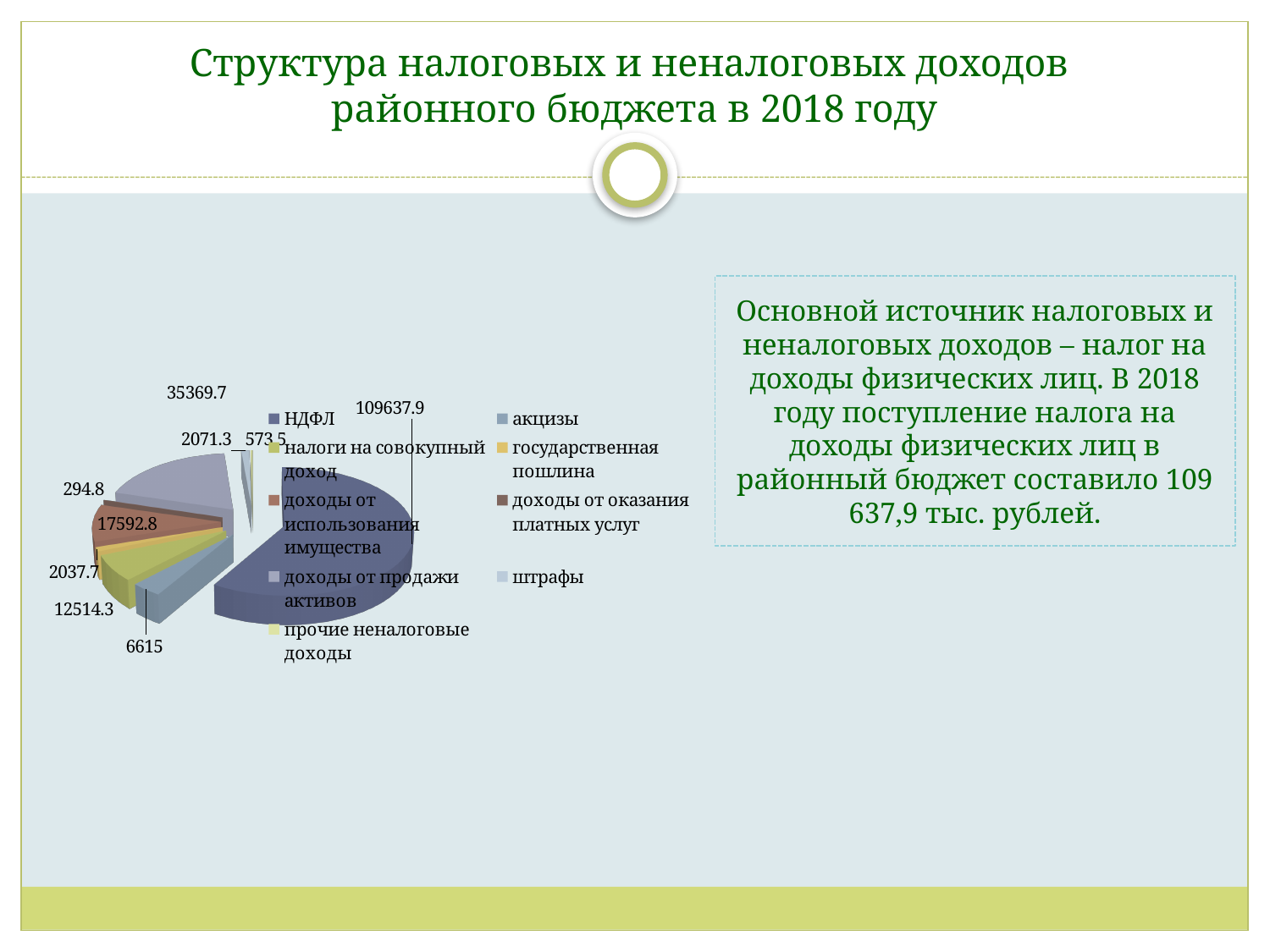
How many entries does the legend of the pie chart list? 9 Which legend entry is listed first in the pie chart's legend? НДФЛ What kind of chart is shown on the slide? pie chart What is the largest data label shown on the pie chart? 109637.9 Is the value for НДФЛ greater or less than 100000? greater How many slices (data labels) does the pie chart have? 9 Which category has the largest slice of the pie chart? НДФЛ What is the title of the slide containing the pie chart? Структура налоговых и неналоговых доходов районного бюджета в 2018 году What is the difference between the largest data label (109637.9) and the second largest (35369.7) on the pie chart? 74268.2 What value is shown for НДФЛ on the pie chart? 109637.9 What is the smallest data label shown on the pie chart? 294.8